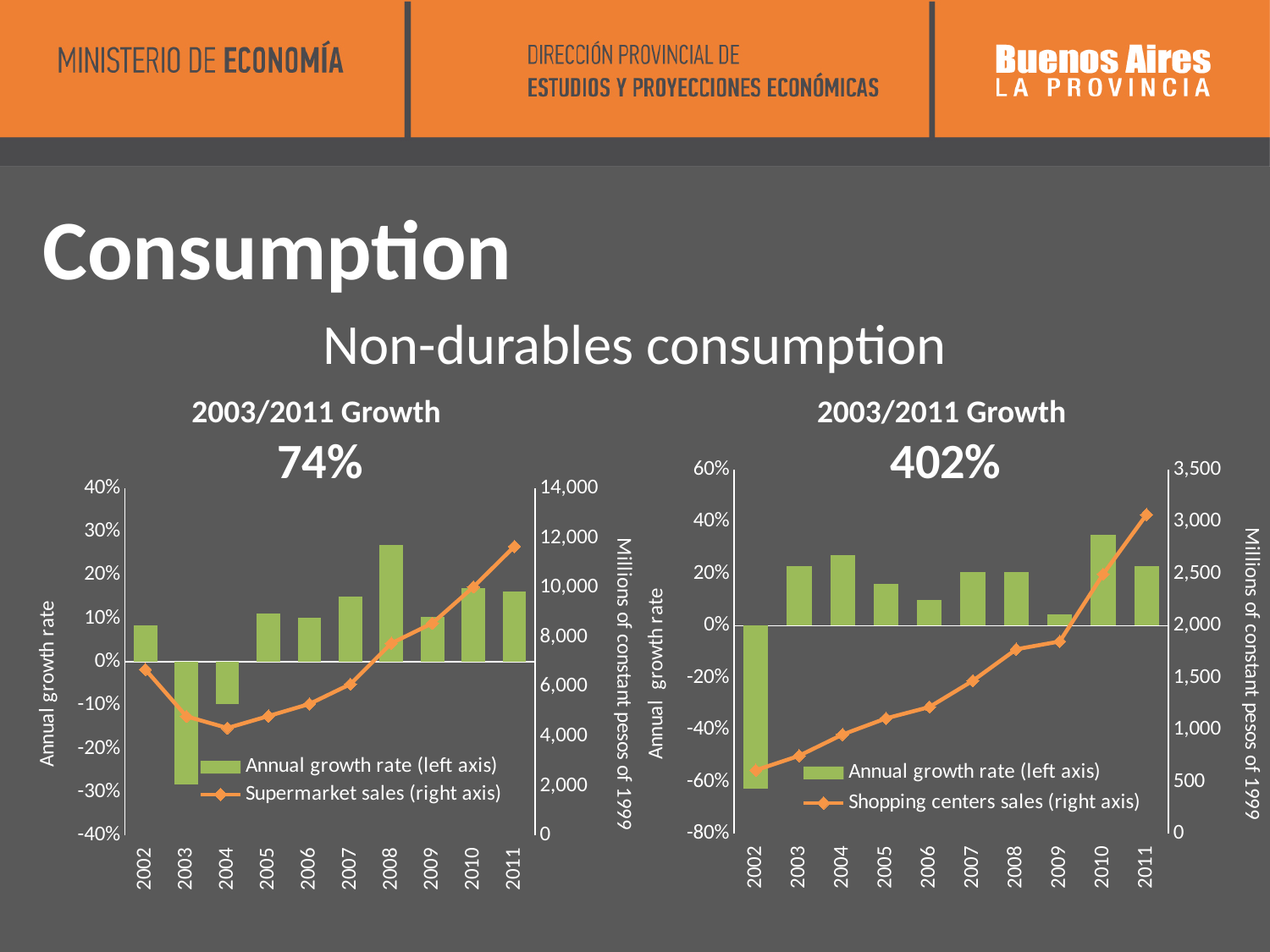
On the right chart, is the annual growth rate for 2002 greater or less than -40%? less On the left chart, is the supermarket sales value for 2011 greater or less than 10,000 million constant pesos of 1999? greater On the right chart (shopping centers sales), what is the 2003/2011 growth figure shown? 402% On the right chart (shopping centers sales), which year has the lowest annual growth rate? 2002 On the left chart (supermarket sales), what is the 2003/2011 growth figure shown? 74% How many years are shown on the x axis of the left chart? 10 On the right chart (shopping centers sales), which year has the highest annual growth rate? 2010 On the right chart, does the shopping centers sales line rise or fall from 2002 to 2011? rise How many series does the legend of the right chart list? 2 On the left chart (supermarket sales), which year has the lowest annual growth rate? 2003 On the left chart (supermarket sales), which year has the highest annual growth rate? 2008